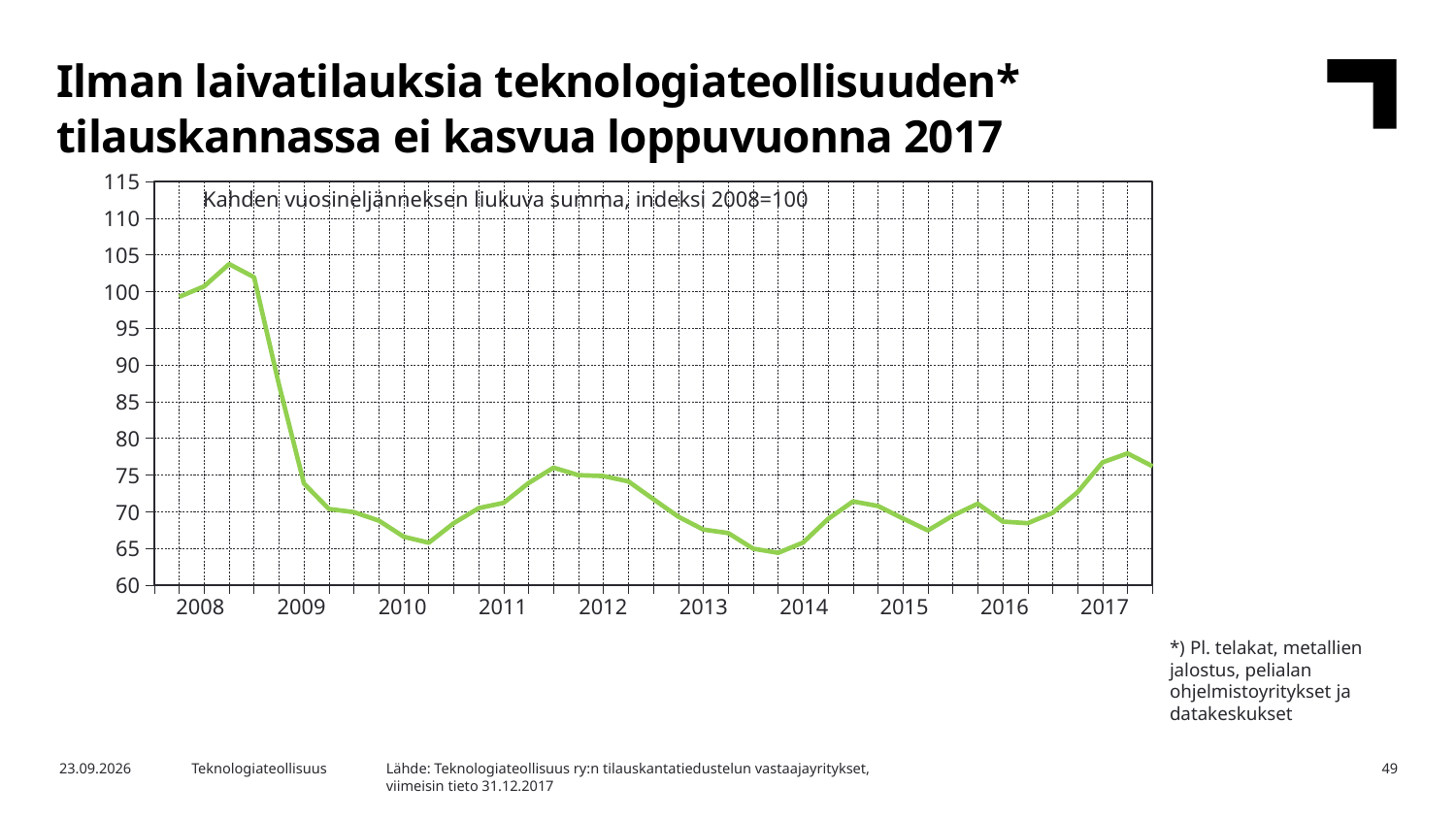
Does the line rise or fall between 2008 and 2009? fall In which year does the line reach its lowest value? 2014 What is the title printed inside the chart area? Kahden vuosineljänneksen liukuva summa, indeksi 2008=100 In which year does the line reach its highest value? 2008 Is the lowest value in 2010 greater or less than 70? less Is the value at the end of 2017 greater or less than 70? greater What kind of chart is shown on the slide? line chart How many year labels are shown on the x axis? 10 How many data series are plotted in the chart? 1 Does the line rise or fall between 2016 and 2017? rise Is the lowest value in 2013 greater or less than 70? less